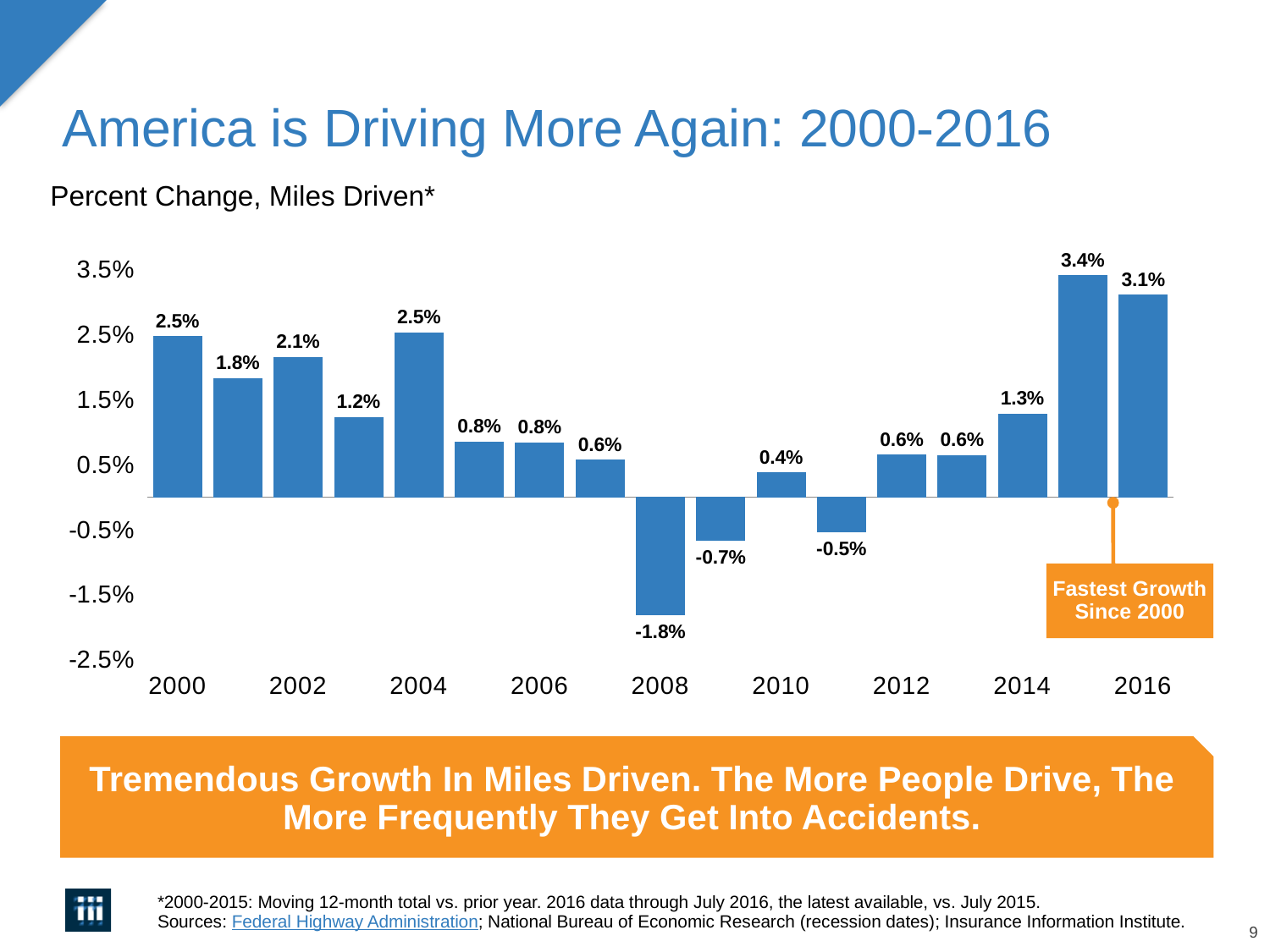
Which year has a larger percent change in miles driven, 2004 or 2010? 2004 What is the percent change in miles driven for 2008? -1.8% Which year has the lowest percent change in miles driven? 2008 What is the percent change in miles driven for 2016? 3.1% What is the highest percent change shown on the chart? 3.4% What is the percent change in miles driven for 2014? 1.3% What is the difference between the percent change in 2016 and in 2014? 1.8 percentage points What is the percent change in miles driven for 2000? 2.5% How many years (bars) are plotted on the chart? 17 What does the orange callout on the chart say? Fastest Growth Since 2000 What kind of chart is shown on the slide? Bar chart Is the value for 2012 greater or less than 1.5%? less